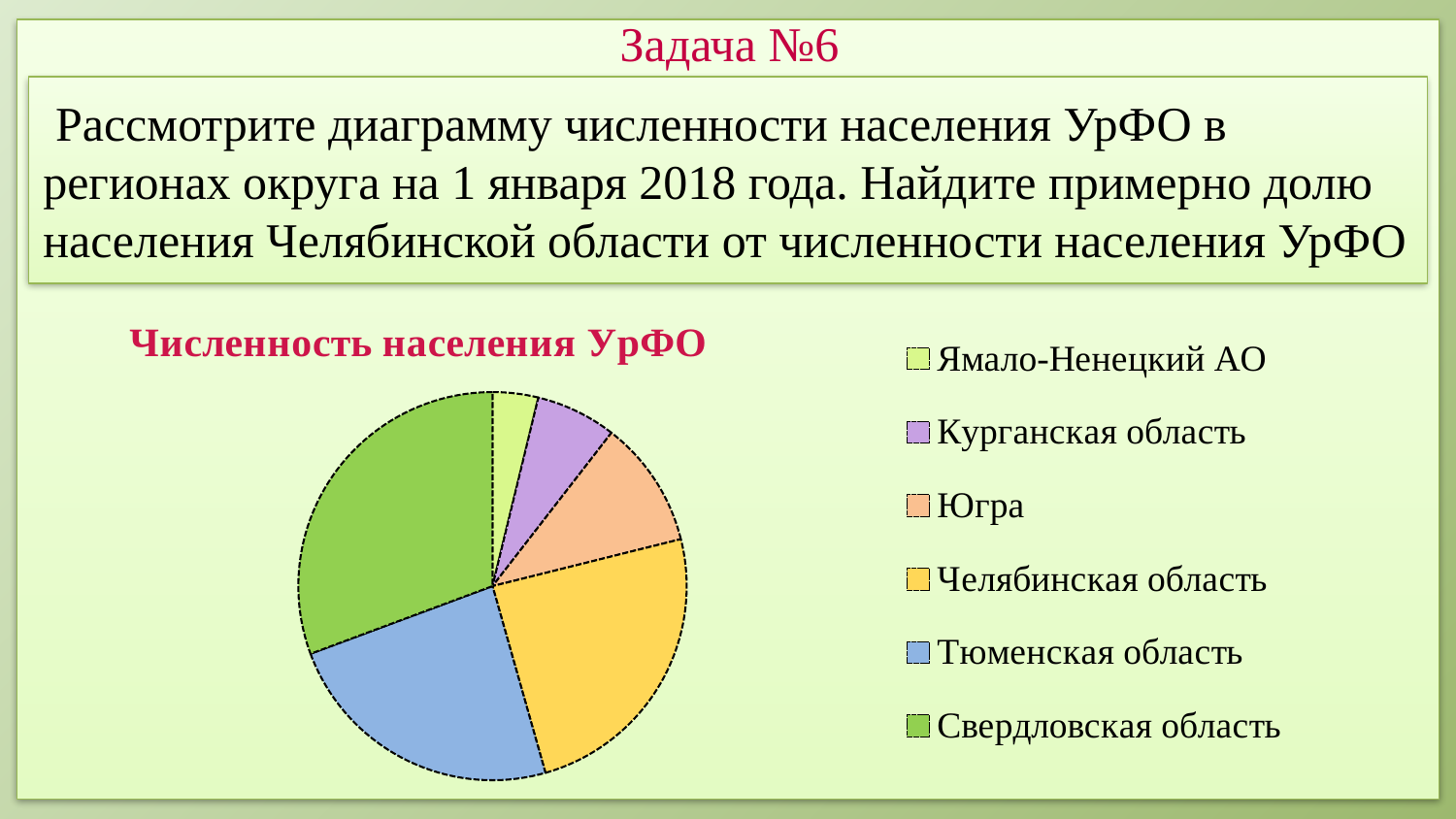
Which region has the smallest slice in the pie chart? Ямало-Ненецкий АО What is the title of the pie chart? Численность населения УрФО How many entries does the legend of the pie chart list? 6 How many regions (slices) does the pie chart show? 6 Which slice is larger: Югра or Ямало-Ненецкий АО? Югра Which slice is larger: Челябинская область or Югра? Челябинская область Which slice is larger: Свердловская область or Курганская область? Свердловская область Which region has the largest slice in the pie chart? Свердловская область What kind of chart is shown on the slide? pie chart Which region is shown in green in the pie chart? Свердловская область